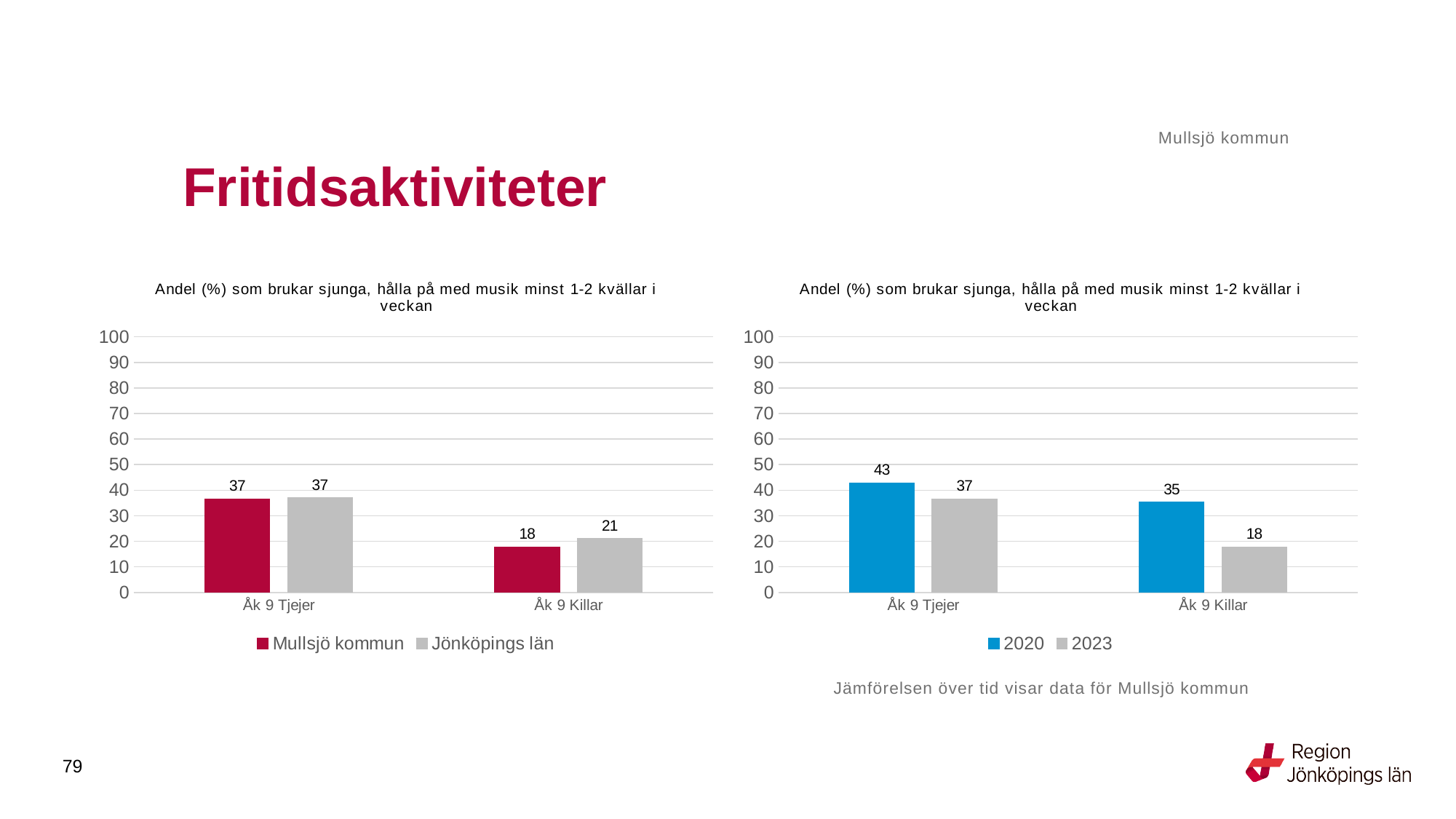
In the right chart, which bar has the highest value? 2020, Åk 9 Tjejer In the right chart, what is the difference between 2020 and 2023 for Åk 9 Tjejer? 6 In the right chart, what is the value for 2023 for Åk 9 Killar? 18 In the left chart, what kind of chart is shown? Bar chart In the left chart, how many series does the legend list? 2 In the left chart, what is the value for Mullsjö kommun for Åk 9 Tjejer? 37 In the right chart, what is the value for 2020 for Åk 9 Tjejer? 43 In the right chart, which is larger for Åk 9 Killar: 2020 or 2023? 2020 In the right chart, how many categories are shown on the x axis? 2 In the left chart, what is the value for Jönköpings län for Åk 9 Killar? 21 In the right chart, what are the two legend entries? 2020 and 2023 In the left chart, what is the difference between Jönköpings län and Mullsjö kommun for Åk 9 Killar? 3